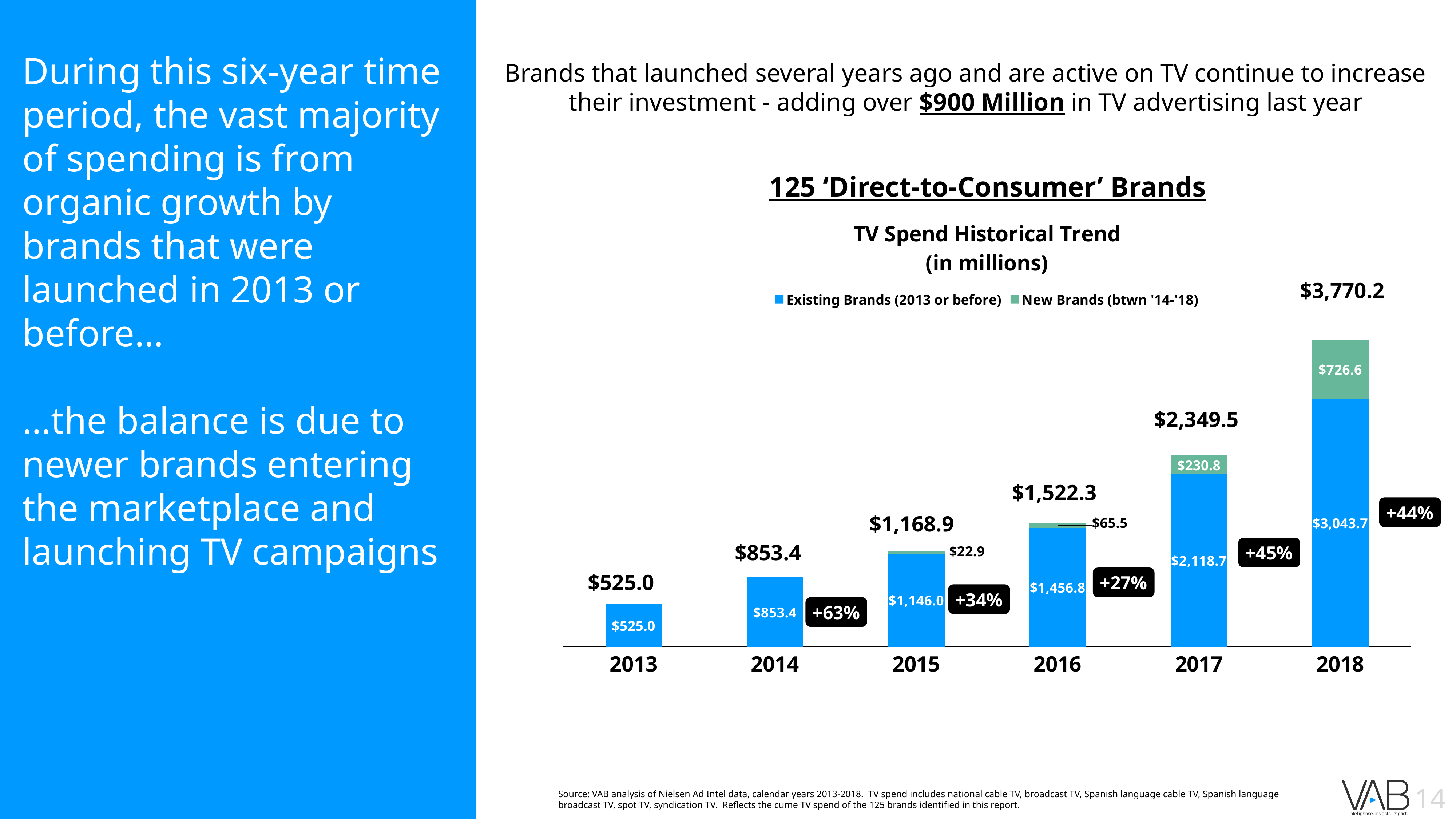
What is the difference between the Existing Brands values for 2018 and 2017? $925.0 What is the total TV spend shown above the stacked bar for 2016? $1,522.3 What kind of chart is shown? Stacked bar chart Which is larger: the New Brands value in 2017 or the New Brands value in 2016? 2017 How many years are shown on the x axis? 6 Which year has the highest total TV spend? 2018 Do the total TV spend values rise or fall from 2013 to 2018? Rise What is the value for New Brands (btwn '14-'18) in 2018? $726.6 What is the value for New Brands (btwn '14-'18) in 2015? $22.9 What is the value for Existing Brands (2013 or before) in 2017? $2,118.7 How many series does the legend list? 2 Which year has the lowest total TV spend? 2013